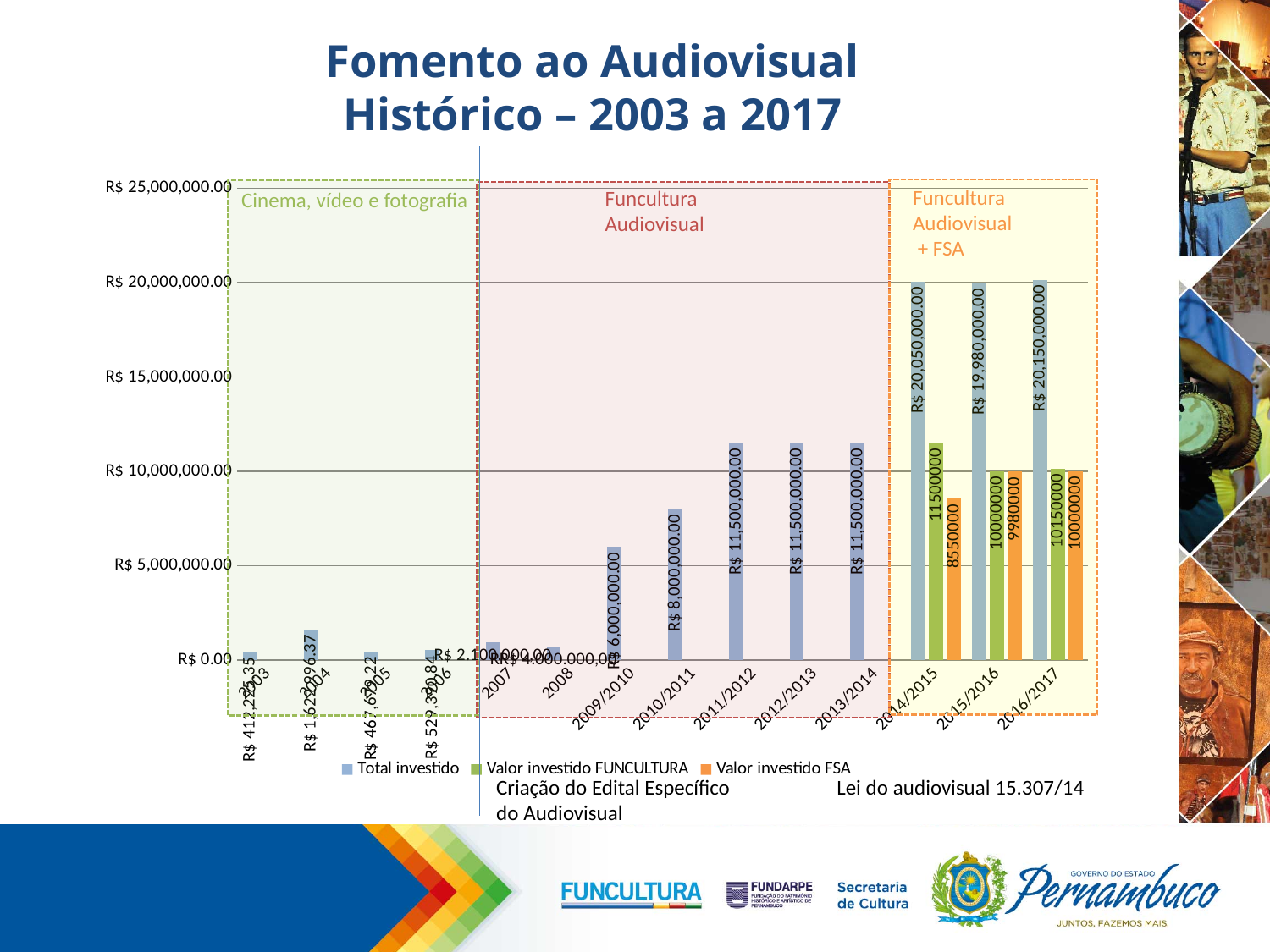
Which period has the highest Total investido? 2016/2017 How many periods are shown on the x axis of the chart? 14 What is the Valor investido FUNCULTURA for 2016/2017? 10150000 How many series does the legend list? 3 What is the difference between the Total investido in 2016/2017 and in 2015/2016? R$ 170,000.00 What is the Total investido for 2010/2011? R$ 8,000,000.00 What is the Valor investido FSA for 2015/2016? 9980000 Which has a larger Total investido, 2009/2010 or 2010/2011? 2010/2011 What kind of chart is shown on the slide? bar chart Is the Total investido for 2013/2014 greater or less than R$ 10,000,000.00? greater What is the difference between the Valor investido FUNCULTURA and the Valor investido FSA in 2014/2015? 2950000 What is the Total investido for 2014/2015? R$ 20,050,000.00